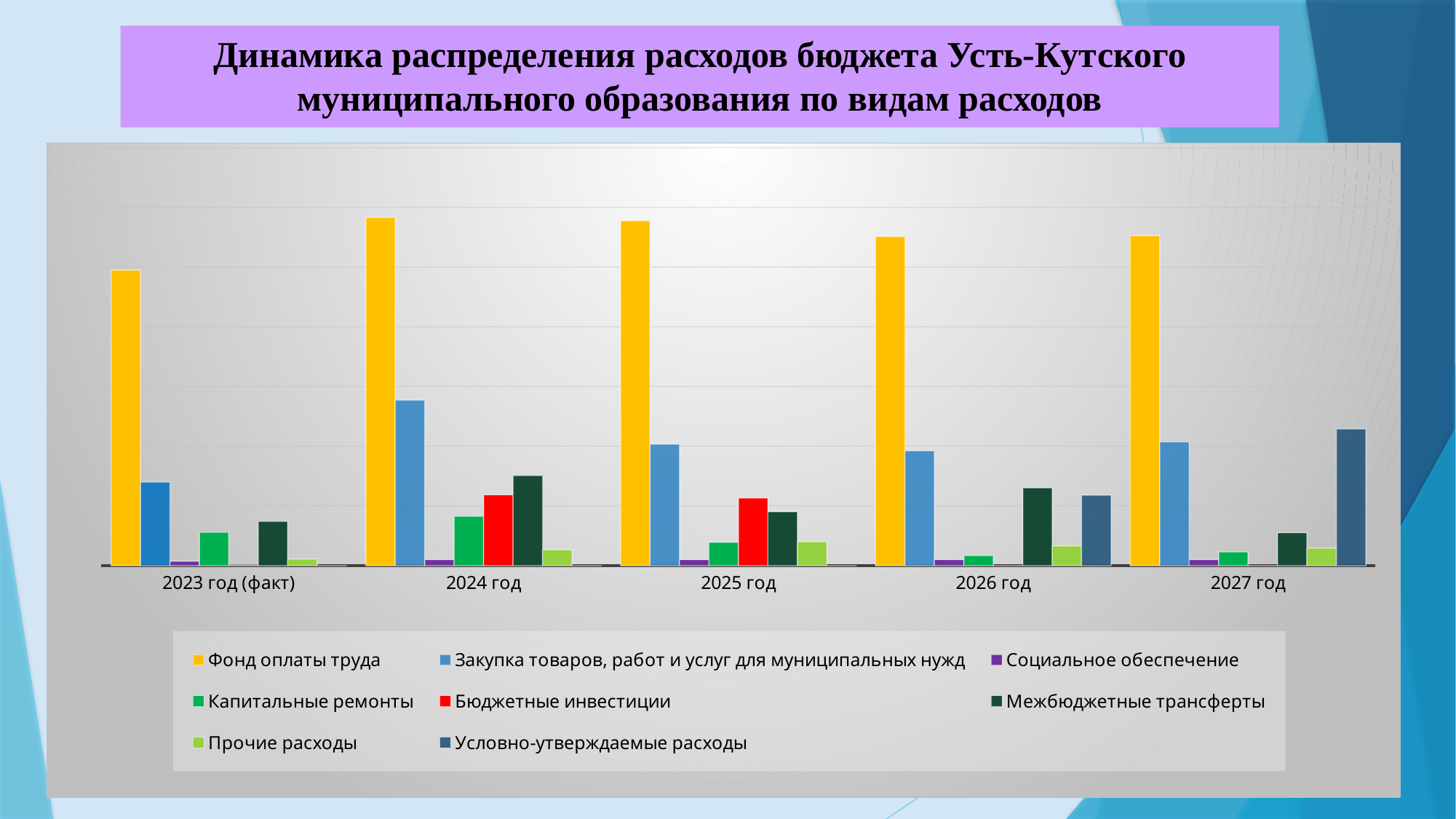
Which series has the tallest bar in every year? Фонд оплаты труда What is the title of the slide? Динамика распределения расходов бюджета Усть-Кутского муниципального образования по видам расходов How many year categories are shown on the x axis? 5 In which year is the bar for Фонд оплаты труда the lowest? 2023 год (факт) What colour represents Фонд оплаты труда in the legend? Yellow Is the bar for Бюджетные инвестиции larger in 2023 год (факт) or in 2024 год? 2024 год In which year is the bar for Капитальные ремонты the highest? 2024 год Does the bar for Условно-утверждаемые расходы rise or fall from 2026 год to 2027 год? Rise In which year is the bar for Закупка товаров, работ и услуг для муниципальных нужд the highest? 2024 год How many series does the legend list? 8 What kind of chart is shown on the slide? Bar chart Is the bar for Условно-утверждаемые расходы larger in 2026 год or in 2027 год? 2027 год